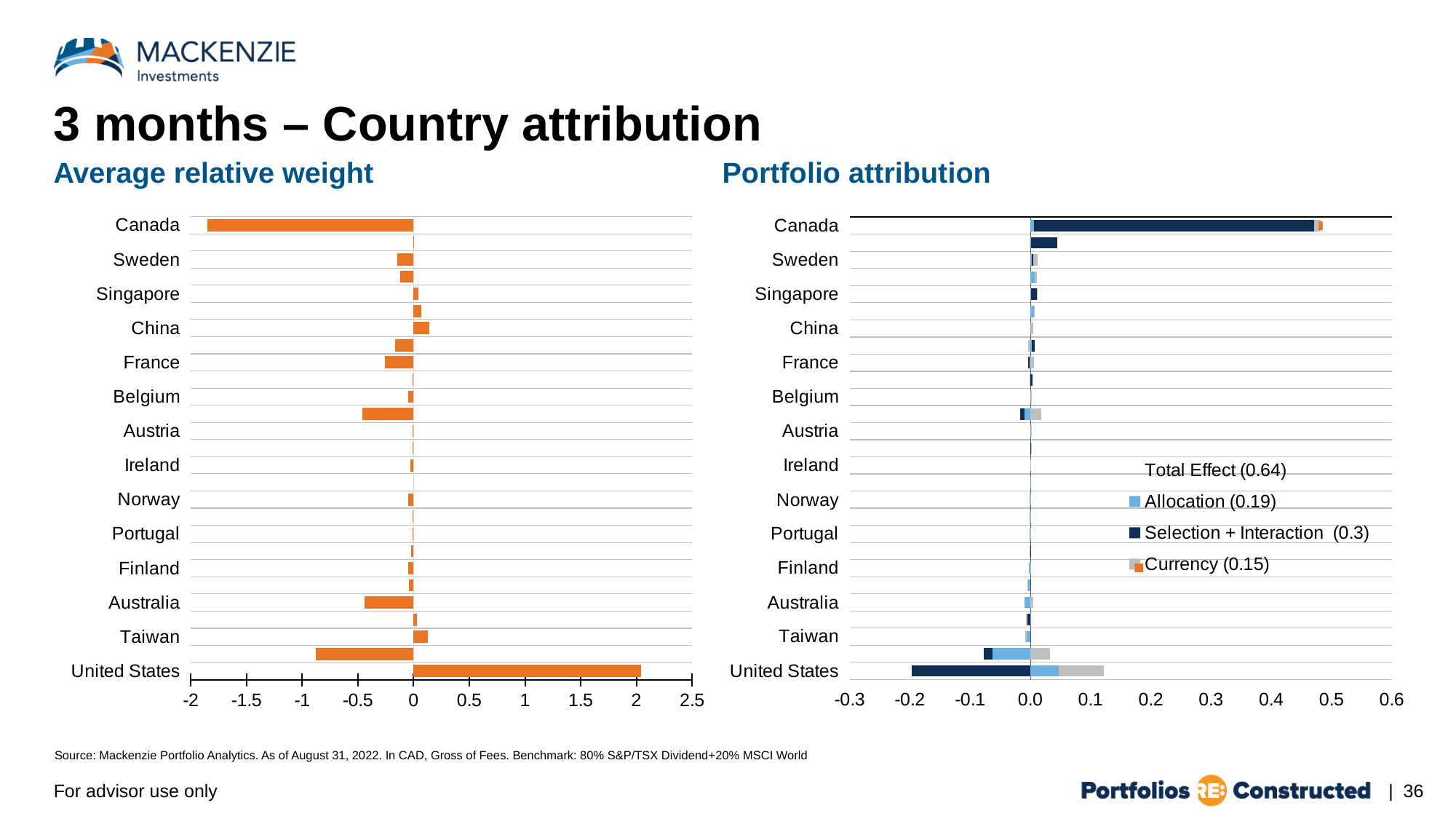
In the 'Average relative weight' chart, is the value for Australia greater or less than 0? less How many series does the legend of the 'Portfolio attribution' chart list? 4 In the 'Average relative weight' chart, which is larger, the value for United States or the value for Canada? United States In the 'Average relative weight' chart, which country has the lowest value? Canada In the 'Average relative weight' chart, which country has the highest value? United States In the 'Portfolio attribution' chart, is the Selection + Interaction value for Canada greater or less than 0.4? greater What Total Effect value is shown in the legend of the 'Portfolio attribution' chart? 0.64 In the 'Average relative weight' chart, is the value for United States greater or less than 1.5? greater What kind of chart is the 'Average relative weight' chart? bar chart In the 'Portfolio attribution' chart, which country has the largest positive bar? Canada